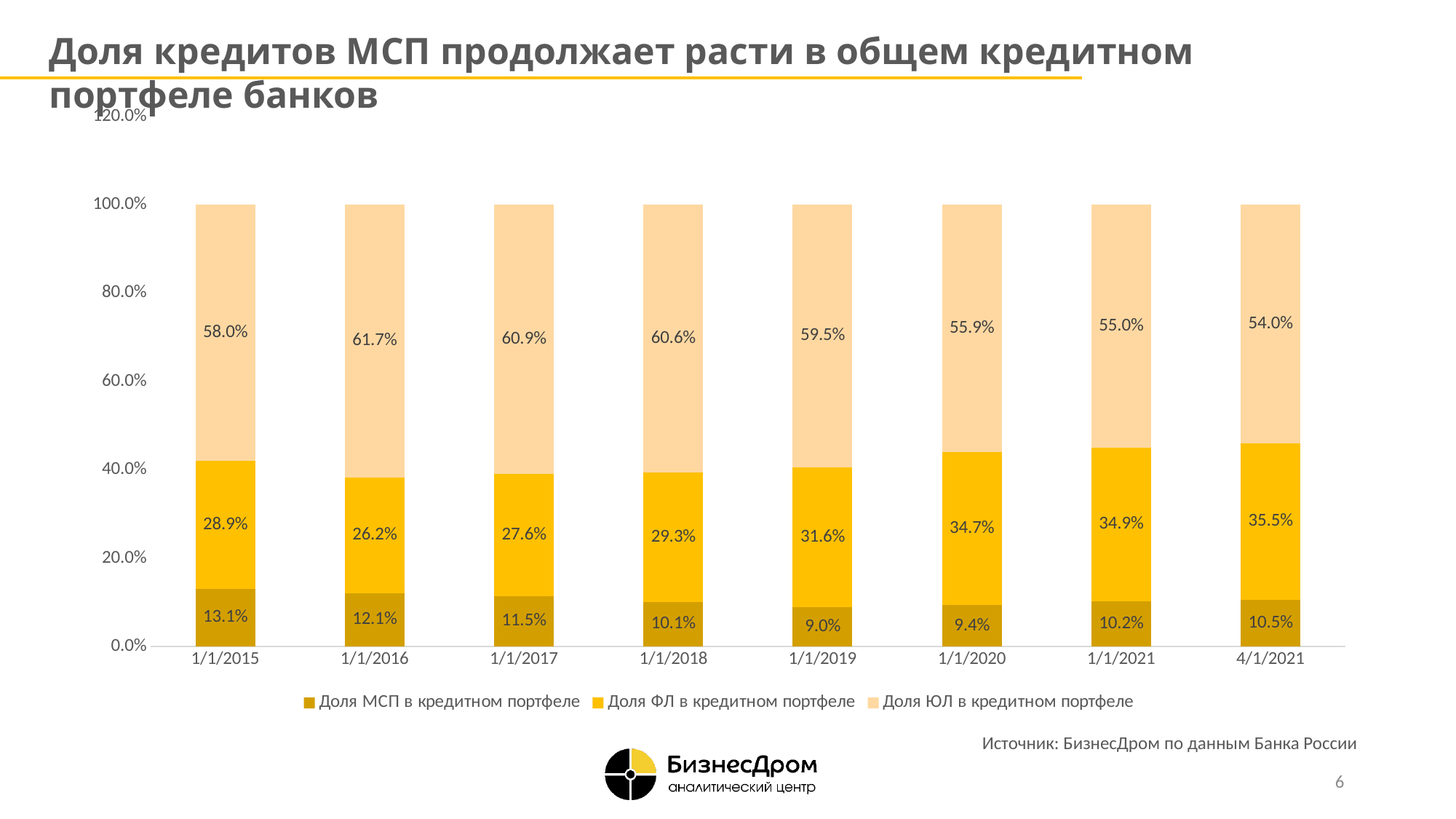
Does Доля ФЛ в кредитном портфеле rise or fall from 1/1/2018 to 4/1/2021? Rise What is the value of Доля МСП в кредитном портфеле for 1/1/2015? 13.1% What is the total of the stacked bar for 1/1/2020? 100.0% What is the value of Доля ЮЛ в кредитном портфеле for 1/1/2016? 61.7% For which date is Доля МСП в кредитном портфеле lowest? 1/1/2019 How many series does the legend list? 3 Which is larger: Доля МСП в кредитном портфеле on 1/1/2015 or on 1/1/2020? 1/1/2015 For which date is Доля ЮЛ в кредитном портфеле highest? 1/1/2016 What is the difference between Доля ФЛ в кредитном портфеле on 4/1/2021 and on 1/1/2015? 6.6% What is the value of Доля ФЛ в кредитном портфеле for 4/1/2021? 35.5% How many dates are shown on the x axis? 8 What kind of chart is shown on the slide? Stacked bar chart